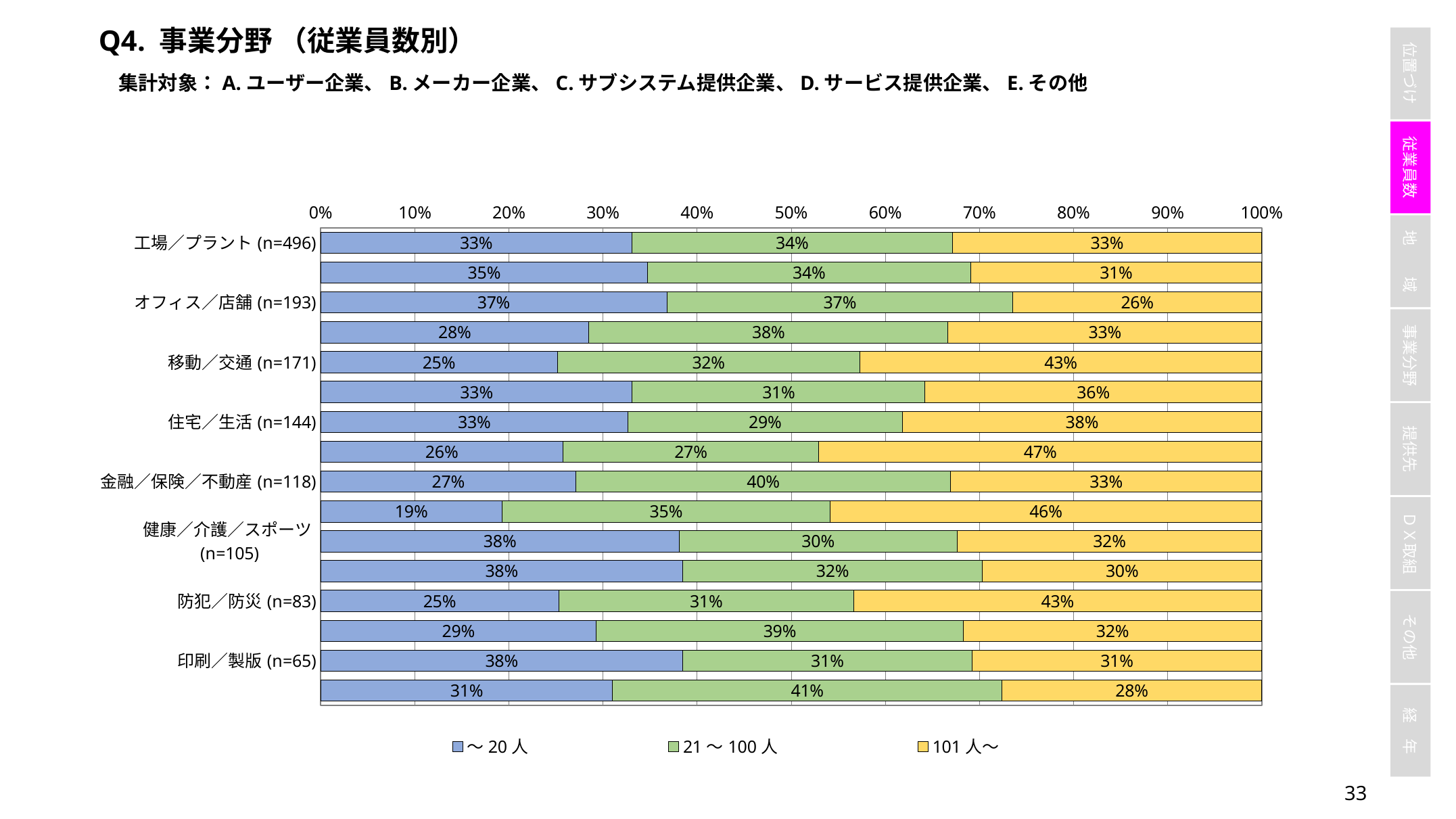
Which is larger: the ～20人 value for 健康／介護／スポーツ (n=105) or the ～20人 value for 移動／交通 (n=171)? 健康／介護／スポーツ (n=105) What is the value of the 101人～ series for オフィス／店舗 (n=193)? 26% What is the value of the 101人～ series for 移動／交通 (n=171)? 43% What is the value of the ～20人 series for 印刷／製版 (n=65)? 38% What is the sample size (n) shown for 工場／プラント? 496 Which is larger for 住宅／生活 (n=144): the 21～100人 value or the 101人～ value? 101人～ What is the value of the ～20人 series for 工場／プラント (n=496)? 33% How many series does the legend list? 3 What kind of chart is shown on the slide? Stacked bar chart What is the difference between the 101人～ value and the ～20人 value for 防犯／防災 (n=83)? 18% What is the value of the 21～100人 series for 金融／保険／不動産 (n=118)? 40% What are the three series listed in the legend? ～20人, 21～100人, 101人～